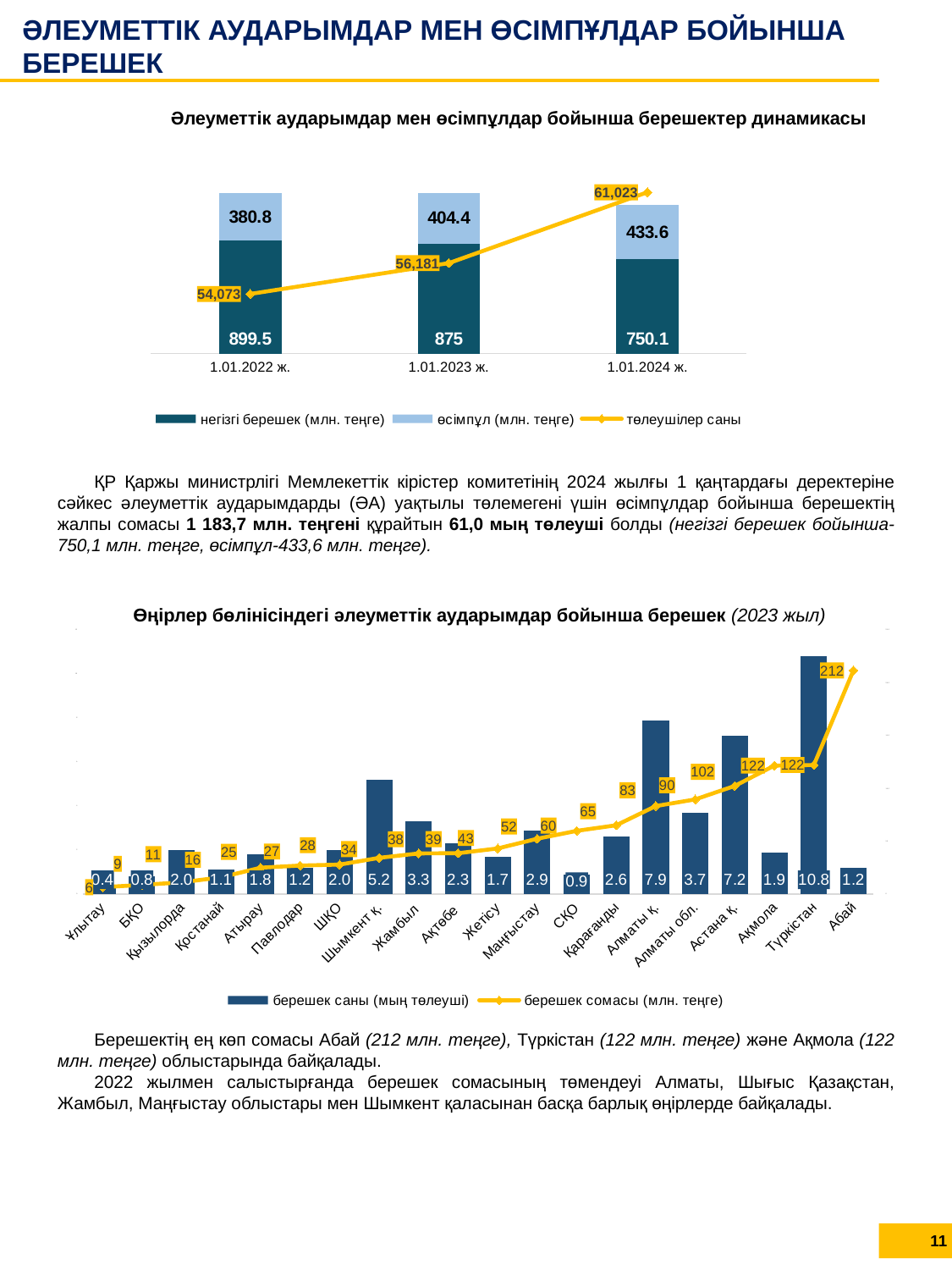
In the top chart, what is the value of өсімпұл (млн. теңге) on 1.01.2022 ж.? 380.8 In the bottom chart, what is the берешек сомасы (млн. теңге) value for Астана қ.? 102 In the top chart, what is the төлеушілер саны value on 1.01.2023 ж.? 56,181 How many regions are shown on the x axis of the bottom chart? 20 In the top chart, what is the total of the stacked bar for 1.01.2024 ж. (негізгі берешек plus өсімпұл)? 1183.7 In the top chart, does the негізгі берешек value rise or fall from 1.01.2022 ж. to 1.01.2024 ж.? fall In the bottom chart (Өңірлер бөлінісіндегі әлеуметтік аударымдар бойынша берешек), which region has the highest берешек саны (мың төлеуші) bar? Түркістан In the bottom chart, what is the difference between the берешек сомасы values for Абай and Түркістан? 90 In the top chart (Әлеуметтік аударымдар мен өсімпұлдар бойынша берешектер динамикасы), what is the value of негізгі берешек (млн. теңге) on 1.01.2024 ж.? 750.1 In the bottom chart, what is the берешек саны (мың төлеуші) value for Алматы қ.? 7.9 How many series does the legend of the top chart list? 3 In the bottom chart, which has the larger берешек саны bar: Шымкент қ. or Жамбыл? Шымкент қ.